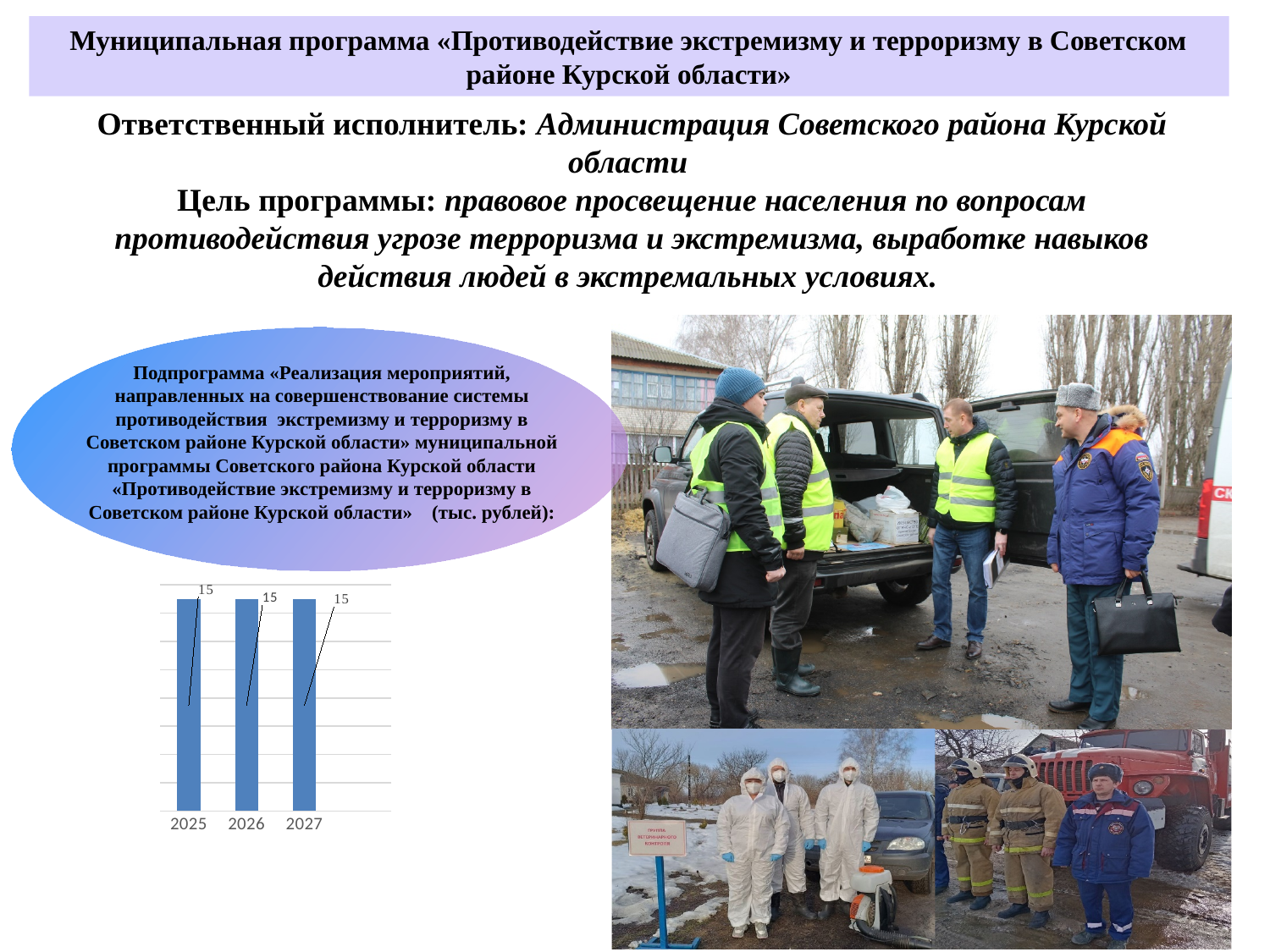
How many categories (years) are shown on the x axis of the bar chart? 3 What is the value for 2026 in the bar chart? 15 What is the difference between the values for 2025 and 2027 in the bar chart? 0 What is the value for 2027 in the bar chart? 15 Do the values in the bar chart rise, fall, or stay the same from 2025 to 2027? stay the same What is the difference between the values for 2026 and 2027 in the bar chart? 0 What kind of chart is shown on the slide? bar chart Which years are shown as categories on the x axis of the bar chart? 2025, 2026, 2027 In what units are the values of the bar chart given, according to the caption above it? тыс. рублей What is the value for 2025 in the bar chart? 15